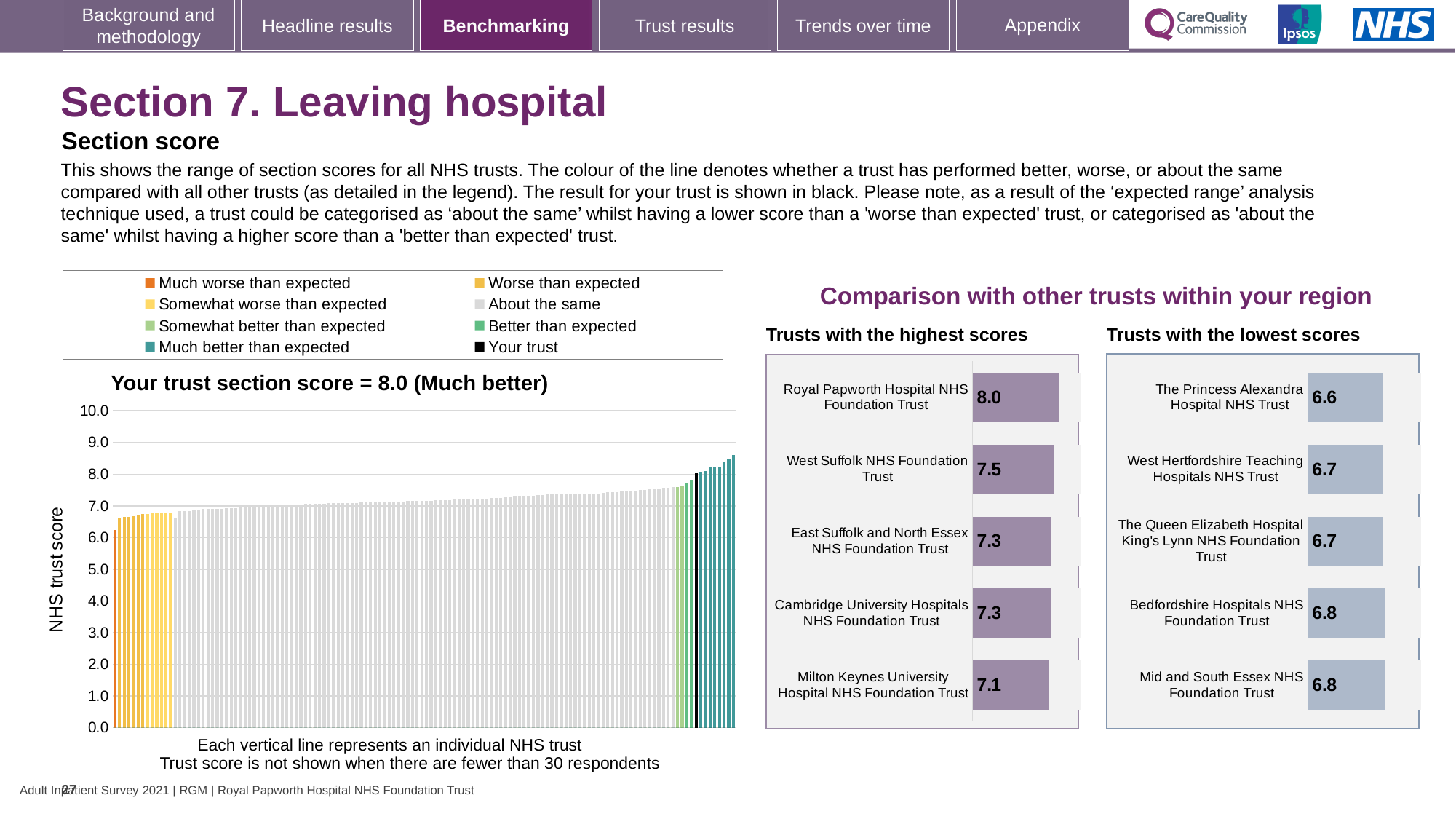
How many trusts are shown in the 'Trusts with the lowest scores' chart? 5 What kind of chart is the 'Your trust section score = 8.0 (Much better)' chart? Bar chart How many entries does the legend of the 'Your trust section score' chart list? 8 In the 'Trusts with the highest scores' chart, what is the score for Royal Papworth Hospital NHS Foundation Trust? 8.0 In the 'Trusts with the highest scores' chart, what is the difference between the scores of Royal Papworth Hospital NHS Foundation Trust and Milton Keynes University Hospital NHS Foundation Trust? 0.9 In the 'Trusts with the lowest scores' chart, what is the score for The Princess Alexandra Hospital NHS Trust? 6.6 In the 'Trusts with the highest scores' chart, what is the score for West Suffolk NHS Foundation Trust? 7.5 In the 'Trusts with the lowest scores' chart, what is the difference between the scores of Bedfordshire Hospitals NHS Foundation Trust and The Princess Alexandra Hospital NHS Trust? 0.2 In the 'Trusts with the highest scores' chart, which trust has the highest score? Royal Papworth Hospital NHS Foundation Trust In the 'Your trust section score' chart, what is the label on the vertical axis? NHS trust score In the 'Trusts with the lowest scores' chart, which trust has the lowest score? The Princess Alexandra Hospital NHS Trust In the 'Trusts with the highest scores' chart, which has the larger score: West Suffolk NHS Foundation Trust or Milton Keynes University Hospital NHS Foundation Trust? West Suffolk NHS Foundation Trust